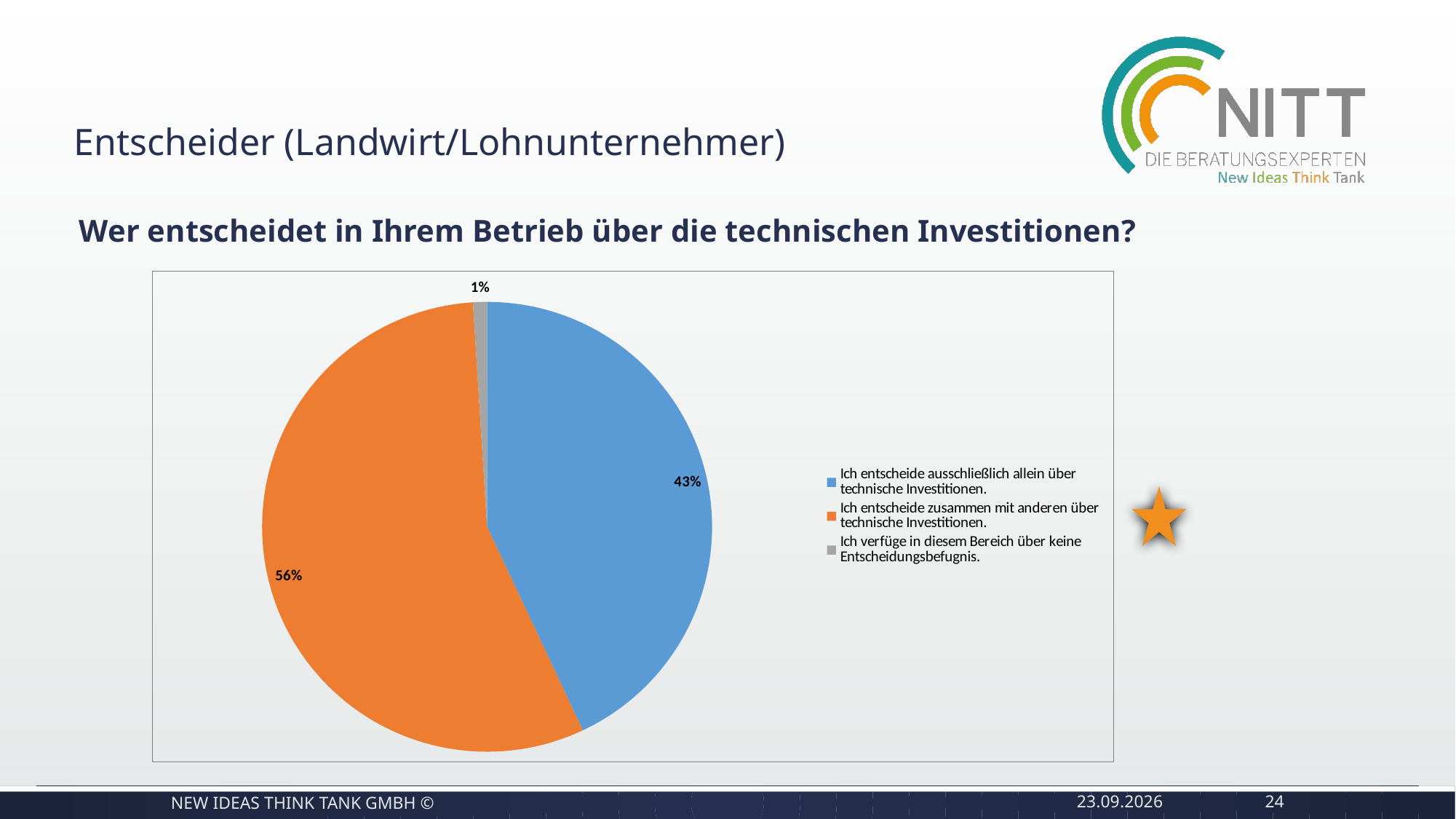
What is the difference in percentage points between the share deciding together with others and the share deciding alone? 13 How many slices does the pie chart have? 3 What colour is the slice for "Ich entscheide ausschließlich allein über technische Investitionen."? blue Which is larger: the share deciding alone or the share deciding together with others? Ich entscheide zusammen mit anderen über technische Investitionen. How many entries does the legend list? 3 Which answer option has the largest share of the pie? Ich entscheide zusammen mit anderen über technische Investitionen. What kind of chart is shown on the slide? pie chart What share of respondents answered "Ich verfüge in diesem Bereich über keine Entscheidungsbefugnis."? 1% Which answer option has the smallest share of the pie? Ich verfüge in diesem Bereich über keine Entscheidungsbefugnis. What question is the chart answering, as written above it? Wer entscheidet in Ihrem Betrieb über die technischen Investitionen? What share of respondents answered "Ich entscheide zusammen mit anderen über technische Investitionen."? 56% What share of respondents answered "Ich entscheide ausschließlich allein über technische Investitionen."? 43%